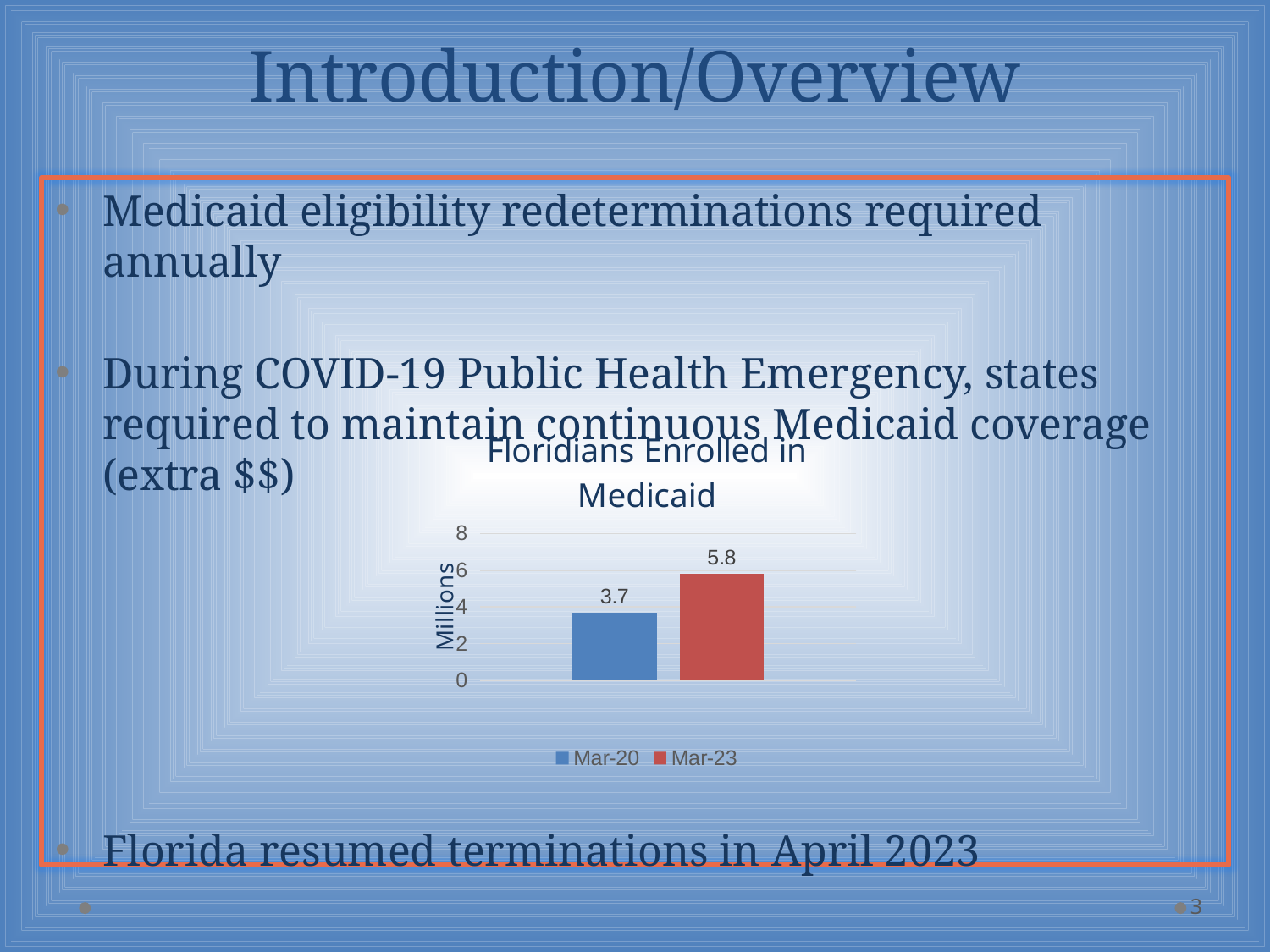
How many series does the legend list in the Floridians Enrolled in Medicaid chart? 2 Is the value for Mar-20 greater or less than 6 in the Floridians Enrolled in Medicaid chart? less What is the value for Mar-20 in the Floridians Enrolled in Medicaid chart? 3.7 Which is larger in the Floridians Enrolled in Medicaid chart, Mar-20 or Mar-23? Mar-23 What is the title of the chart on the slide? Floridians Enrolled in Medicaid Is the value for Mar-23 greater or less than 4 in the Floridians Enrolled in Medicaid chart? greater Which series has the highest value in the Floridians Enrolled in Medicaid chart? Mar-23 What kind of chart is the Floridians Enrolled in Medicaid chart? bar chart What is the label on the vertical axis of the Floridians Enrolled in Medicaid chart? Millions What is the difference between the Mar-23 and Mar-20 values in the Floridians Enrolled in Medicaid chart? 2.1 Which series has the lowest value in the Floridians Enrolled in Medicaid chart? Mar-20 What is the value for Mar-23 in the Floridians Enrolled in Medicaid chart? 5.8